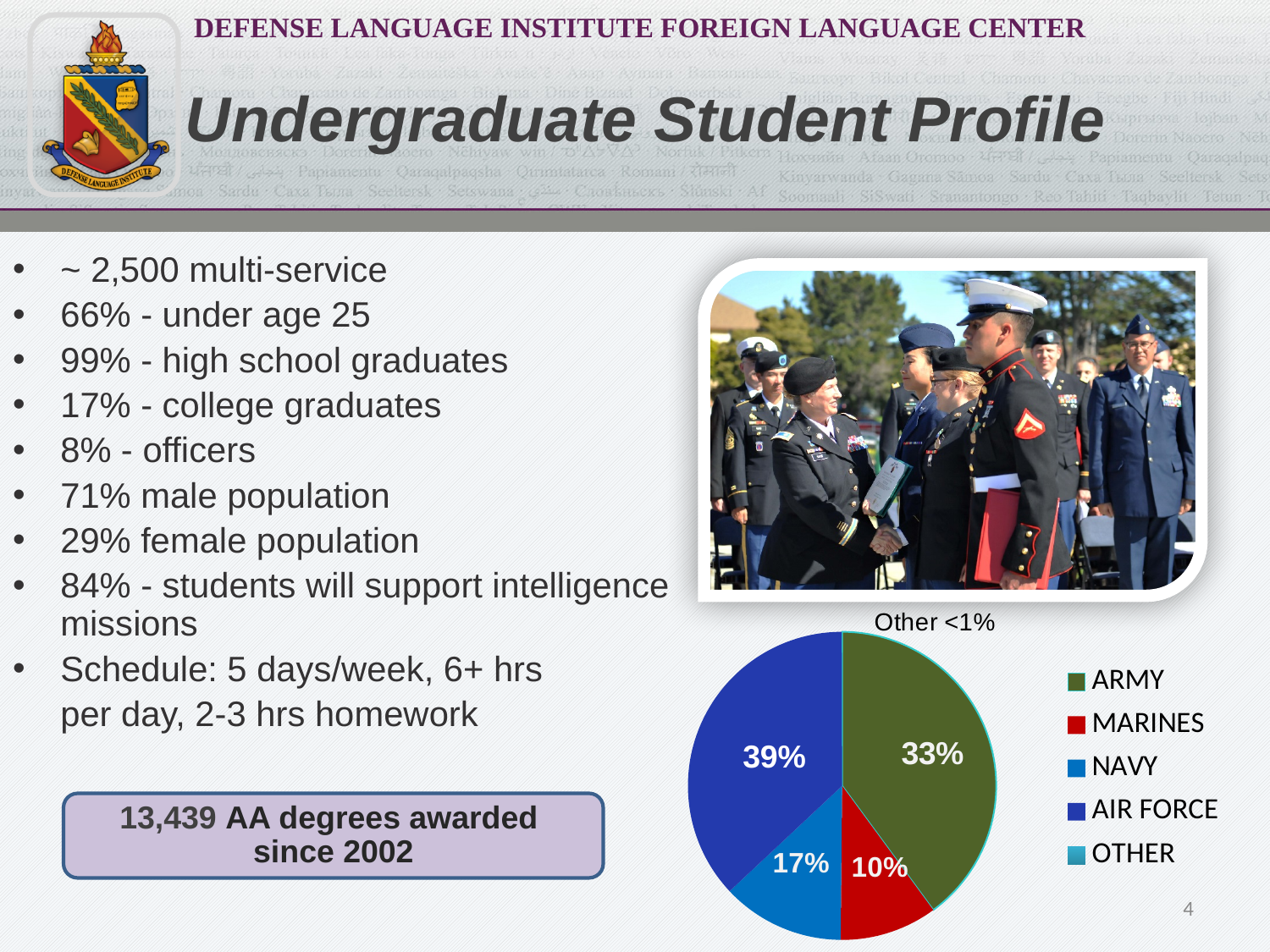
Which is larger, the NAVY slice or the MARINES slice? NAVY What is the difference in percentage points between the AIR FORCE and ARMY slices? 6 What share of the pie is labelled for OTHER? <1% What share of the pie does NAVY represent? 17% What kind of chart is shown on the slide? pie chart Which category has the smallest slice of the pie? OTHER What share of the pie does MARINES represent? 10% What share of the pie does ARMY represent? 33% What colour is the ARMY slice in the pie chart? green What share of the pie does AIR FORCE represent? 39% How many categories does the legend of the pie chart list? 5